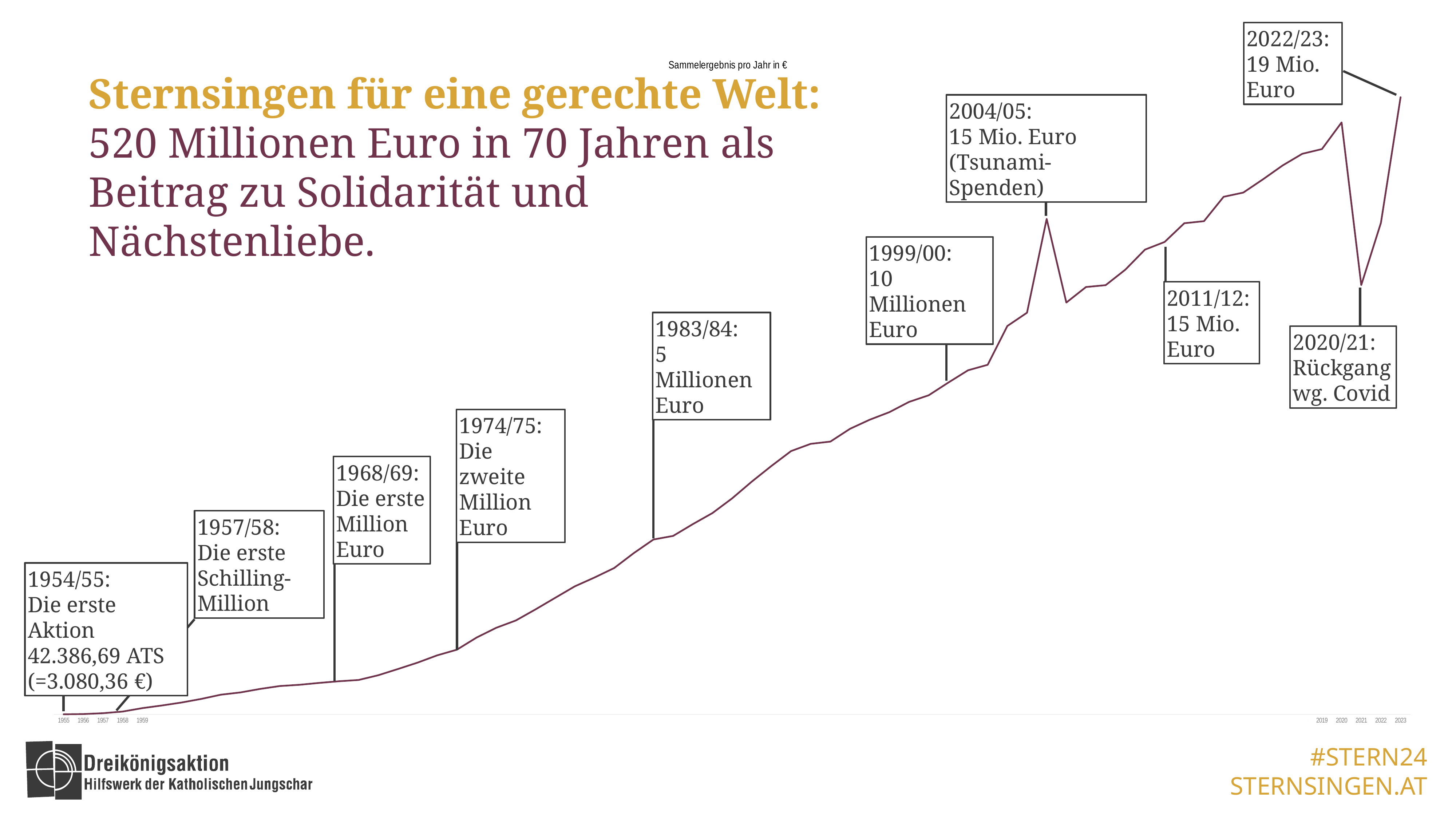
What kind of chart is shown on the slide? line chart According to the chart annotation, what was the 1954/55 result in euros? 3.080,36 € What is the title of the chart? Sammelergebnis pro Jahr in € In which year does the line reach its highest point? 2023 Which annotated value is larger, 1999/00 or 1983/84? 1999/00 What is the difference between the annotated values for 2022/23 and 2011/12? 4 Mio. Euro What value does the chart annotation give for 1999/00? 10 Millionen Euro Overall, do the values rise or fall along the x axis from 1955 to 2023? rise According to the chart annotation, what was the result of the first Aktion in 1954/55 in ATS? 42.386,69 ATS What reason does the chart annotation give for the drop in 2020/21? Rückgang wg. Covid What value does the chart annotation give for 1983/84? 5 Millionen Euro What value does the chart annotation give for 2022/23? 19 Mio. Euro